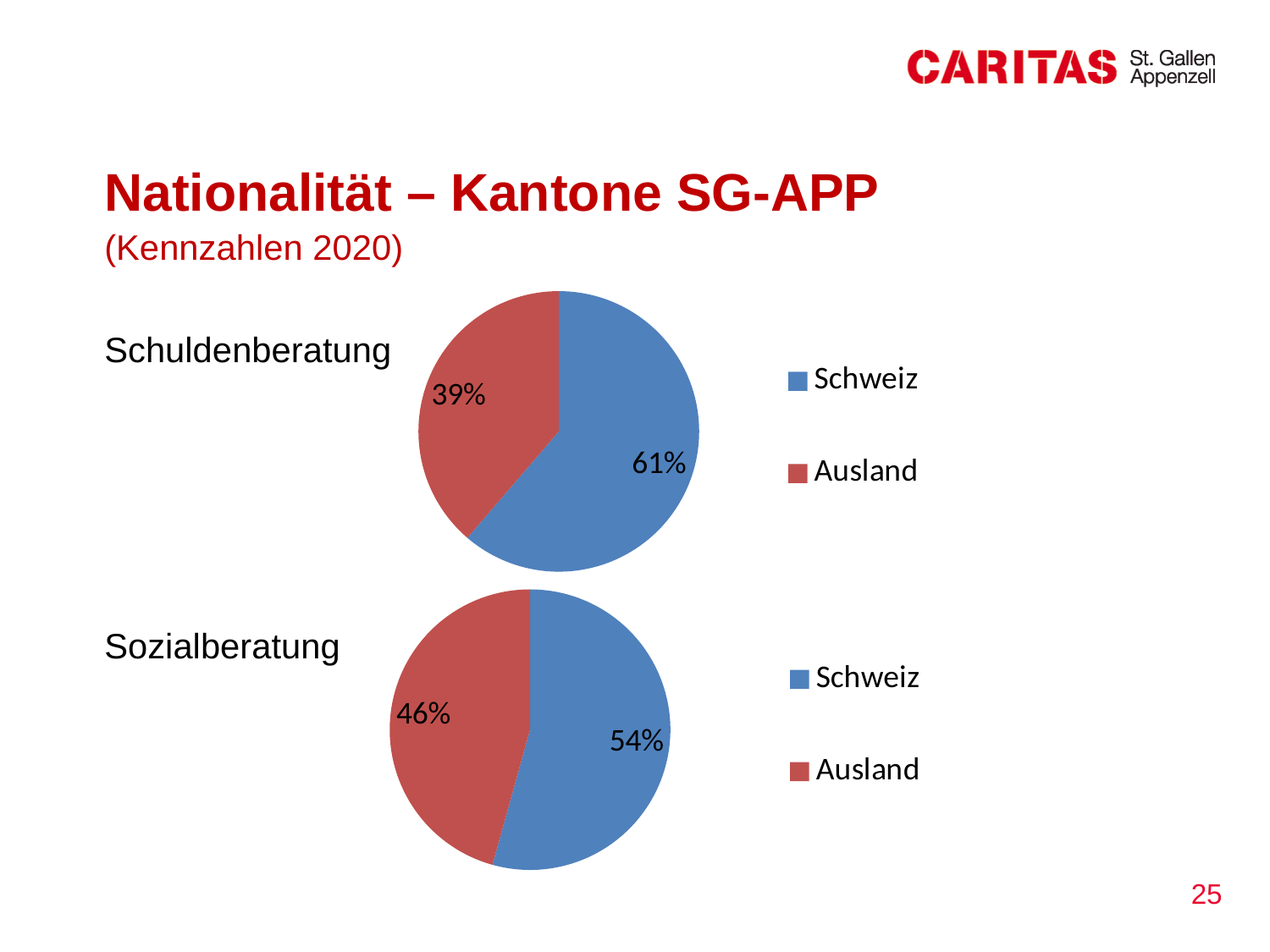
In the Sozialberatung pie chart, which slice is the smallest? Ausland Is the Ausland share larger in the Schuldenberatung pie chart or in the Sozialberatung pie chart? Sozialberatung In the Sozialberatung pie chart, what share is labelled for Ausland? 46% In the Schuldenberatung pie chart, what is the difference in percentage points between the Schweiz and Ausland slices? 22 In the Schuldenberatung pie chart, what share is labelled for Ausland? 39% In the Schuldenberatung pie chart, which slice is the largest? Schweiz In the Schuldenberatung pie chart, what share is labelled for Schweiz? 61% In the Sozialberatung pie chart, what is the difference in percentage points between the Schweiz and Ausland slices? 8 How many slices does the Sozialberatung pie chart have? 2 In the Sozialberatung pie chart, what share is labelled for Schweiz? 54% In the Schuldenberatung pie chart, which colour represents Ausland? Red What type of chart is used for Schuldenberatung? Pie chart